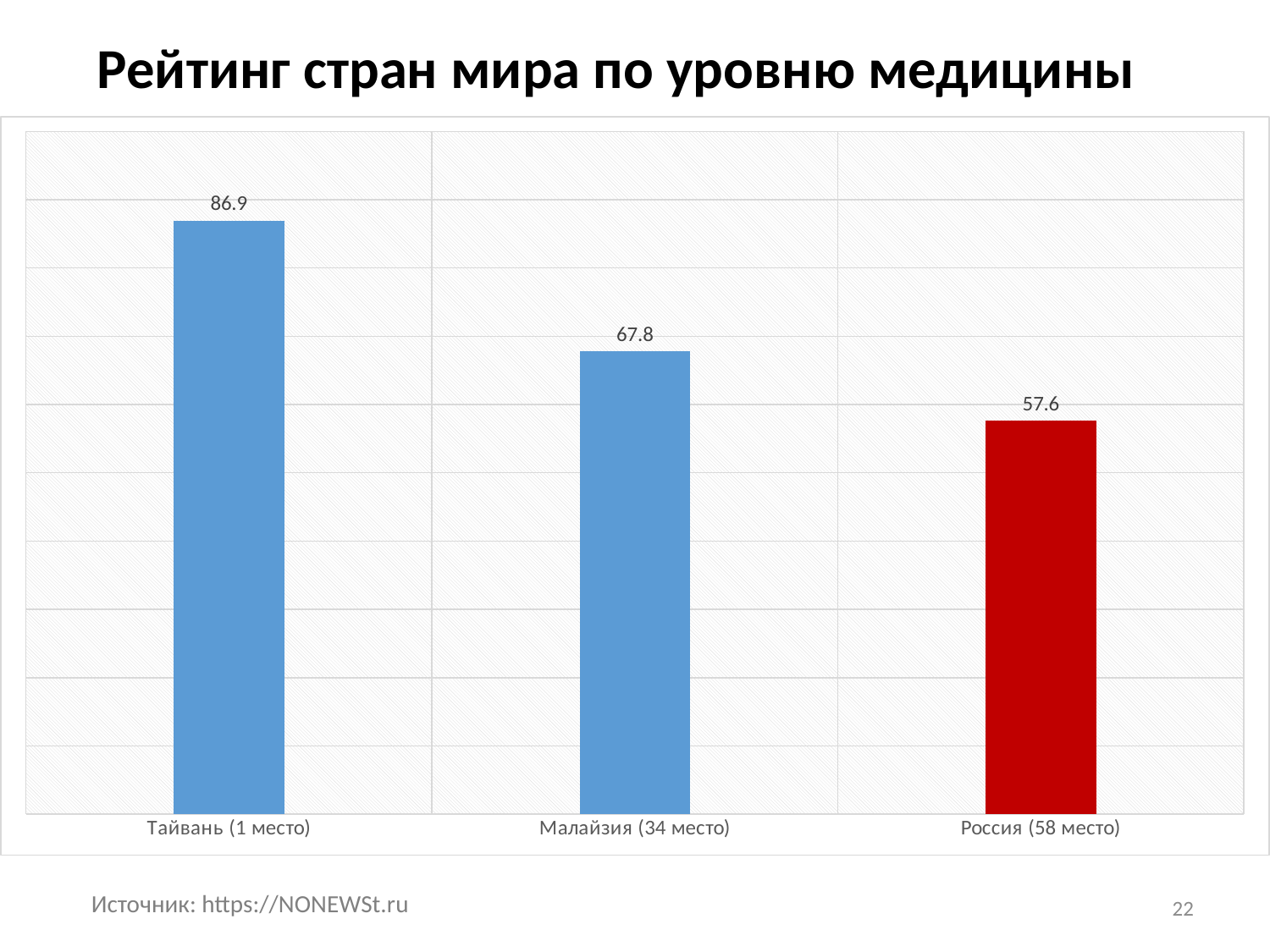
Which category has the lowest value? Россия (58 место) How many categories are shown in the chart? 3 Which bar is coloured red? Россия (58 место) What is the value for Россия (58 место)? 57.6 What is the difference between the values for Тайвань (1 место) and Россия (58 место)? 29.3 Do the values rise or fall from left to right along the x axis? Fall Which category has the highest value? Тайвань (1 место) Which is larger, the value for Малайзия (34 место) or the value for Россия (58 место)? Малайзия (34 место) What kind of chart is shown on the slide? Bar chart What is the difference between the values for Малайзия (34 место) and Россия (58 место)? 10.2 What is the value for Тайвань (1 место)? 86.9 What is the value for Малайзия (34 место)? 67.8